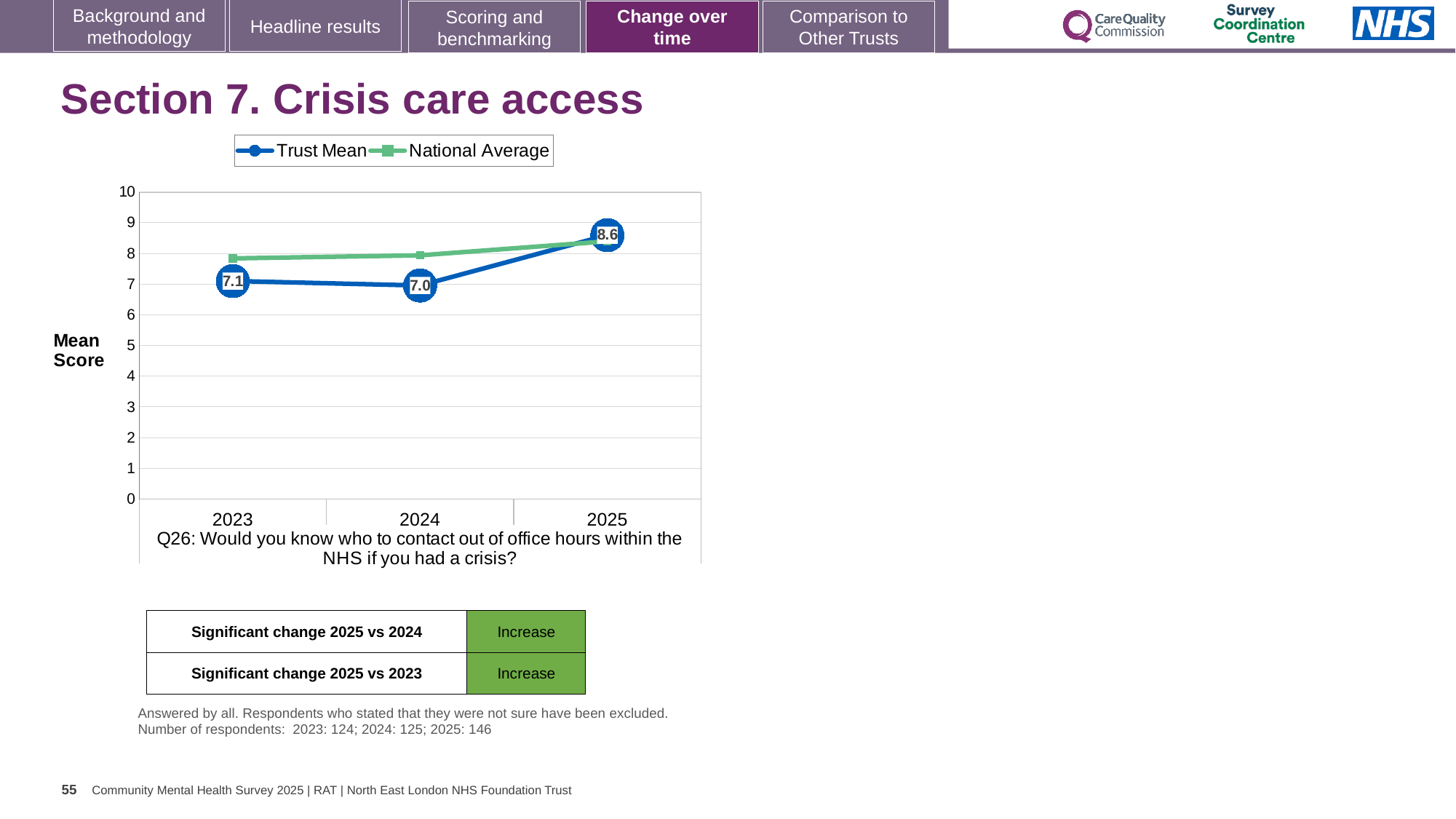
What is the Trust Mean score for 2025? 8.6 What is the Trust Mean score for 2023? 7.1 How many years are plotted on the x axis? 3 How many series does the legend list? 2 What is the label on the y axis of the chart? Mean Score In which year is the Trust Mean highest? 2025 What is the Trust Mean score for 2024? 7.0 Which is higher in 2023, the Trust Mean or the National Average? National Average Is the National Average for 2023 greater or less than 7? greater In which year is the Trust Mean lowest? 2024 What kind of chart is shown on the slide? Line chart By how much did the Trust Mean change from 2024 to 2025? 1.6